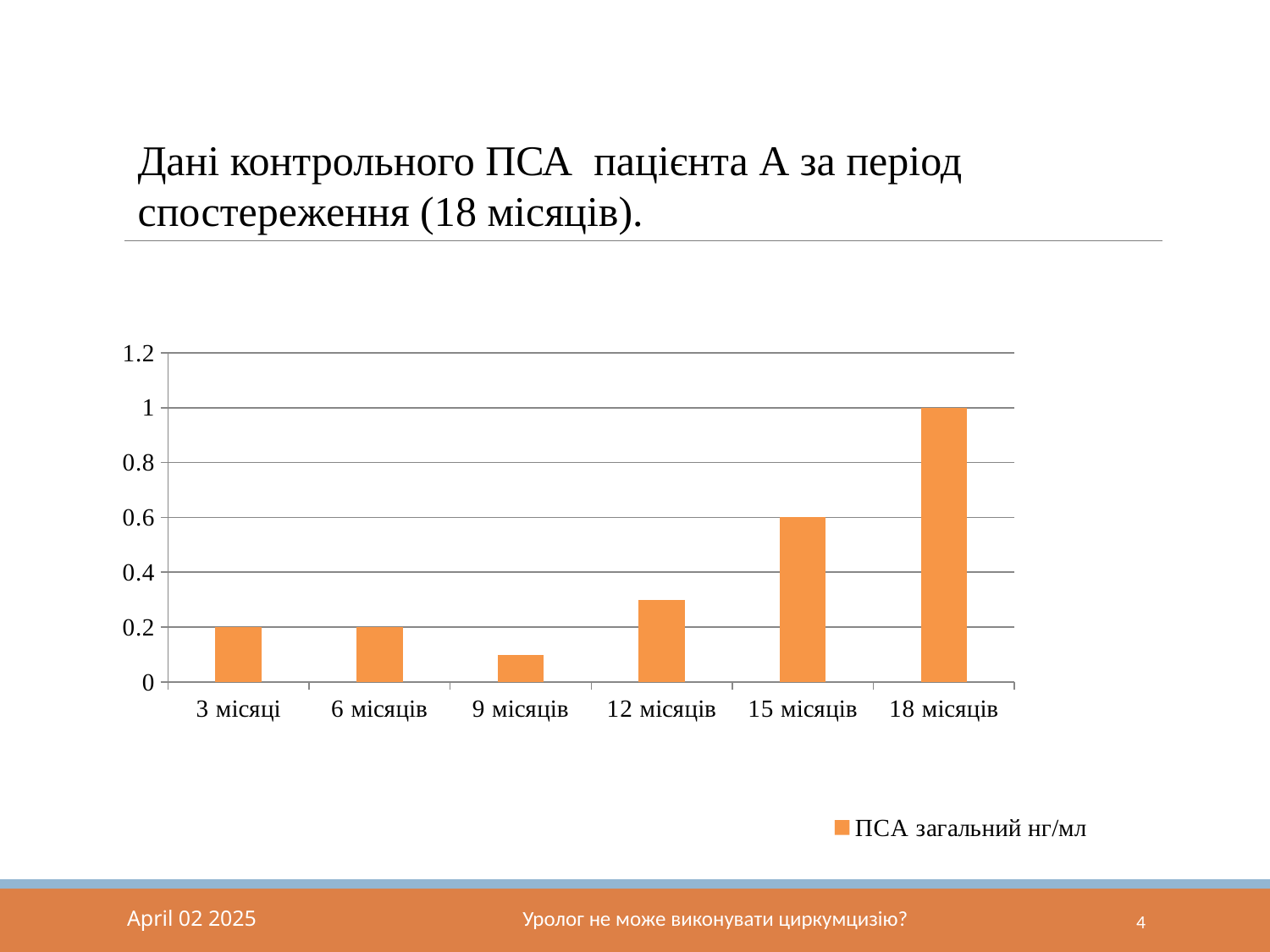
Which time point has the highest value? 18 місяців Which is larger, the value for 15 місяців or the value for 12 місяців? 15 місяців Which time point has the lowest value? 9 місяців Is the value for 9 місяців greater or less than 0.2? less What is the difference between the values for 18 місяців and 15 місяців? 0.4 What is the value for 3 місяці? 0.2 What is the value for 15 місяців? 0.6 What is the value for 18 місяців? 1 How many categories (time points) are shown on the x axis? 6 What kind of chart is shown on the slide? bar chart What is the name of the series shown in the legend? ПСА загальний нг/мл How many series does the legend list? 1